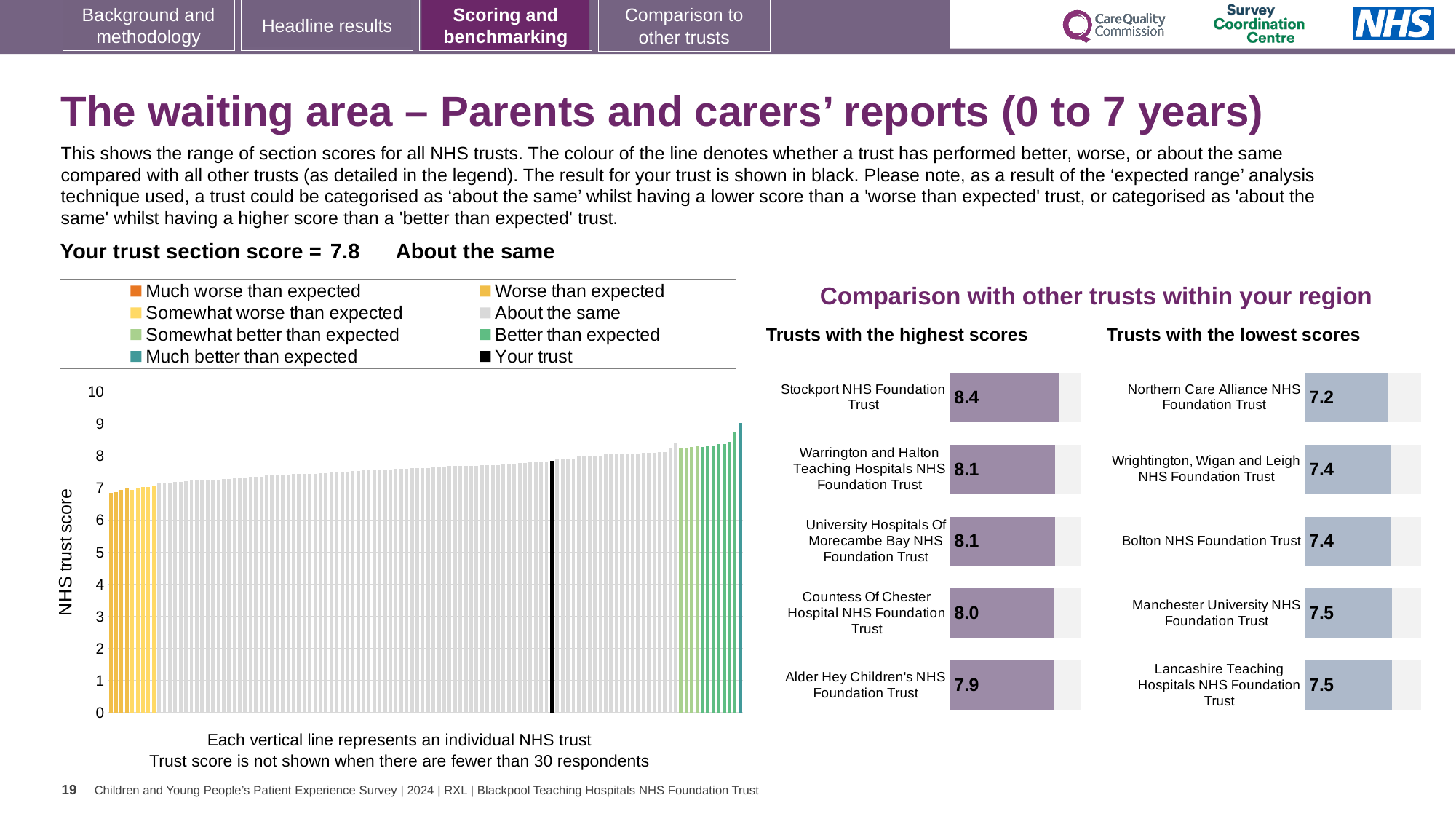
In the 'Trusts with the lowest scores' chart, what is the difference between the scores of Lancashire Teaching Hospitals NHS Foundation Trust and Northern Care Alliance NHS Foundation Trust? 0.3 How many trusts are shown in the 'Trusts with the lowest scores' chart? 5 In the 'Trusts with the highest scores' chart, which has the larger score: Countess Of Chester Hospital NHS Foundation Trust or Alder Hey Children's NHS Foundation Trust? Countess Of Chester Hospital NHS Foundation Trust In the 'Trusts with the highest scores' chart, which trust has the highest score? Stockport NHS Foundation Trust In the 'Trusts with the lowest scores' chart, what is the score for Northern Care Alliance NHS Foundation Trust? 7.2 In the 'Trusts with the highest scores' chart, what is the score for Stockport NHS Foundation Trust? 8.4 In the main 'NHS trust score' chart on the left, do the trust scores rise or fall from left to right? rise How many entries does the legend of the main 'NHS trust score' chart list? 8 In the main 'NHS trust score' chart on the left, what is the section score for your trust? 7.8 In the 'Trusts with the highest scores' chart, what is the difference between the scores of Stockport NHS Foundation Trust and Alder Hey Children's NHS Foundation Trust? 0.5 In the 'Trusts with the lowest scores' chart, which trust has the lowest score? Northern Care Alliance NHS Foundation Trust What kind of chart is the 'Trusts with the highest scores' chart? bar chart